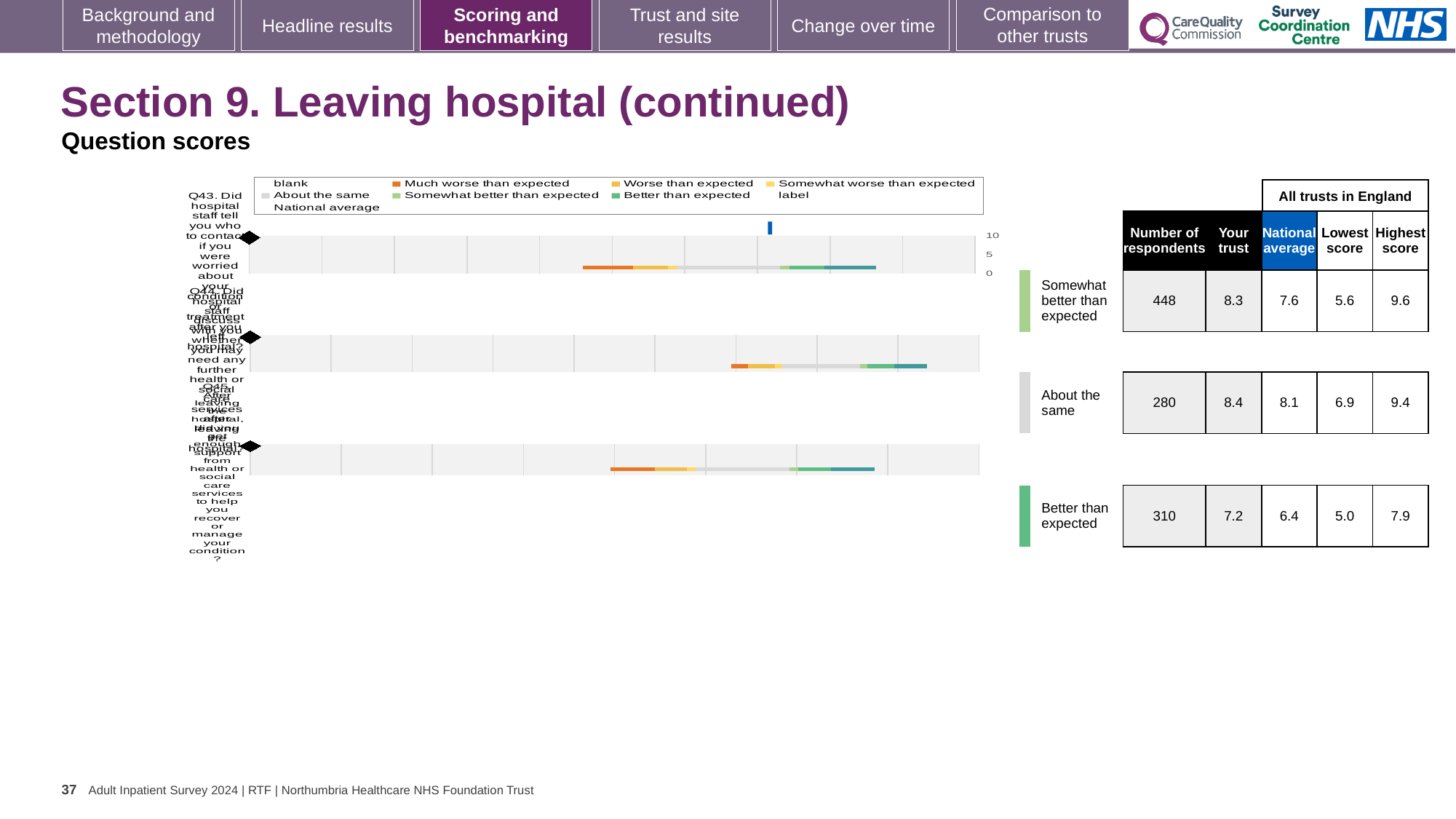
Which question row has the highest 'Your trust' score? The second question (About the same), 8.4 Which benchmark category is the first question (Q43) assigned to? Somewhat better than expected What kind of chart is used to show the question scores on this slide? Bar chart For the third question, which is larger: the 'Your trust' score or the national average? Your trust (7.2) For the first question (Q43), how much higher is the 'Your trust' score than the national average? 0.7 What is the national average score for the third question (the one rated 'Better than expected')? 6.4 How many questions (rows) are plotted in the question scores chart? 3 Which question row has the lowest 'Your trust' score? The third question (Better than expected), 7.2 What is the 'Your trust' score for the first question (Q43, about being told who to contact if worried after leaving hospital)? 8.3 What is the highest score among all trusts in England for the third question? 7.9 How many respondents answered the second question (the one rated 'About the same')? 280 For the second question, what is the difference between the highest score and the lowest score among all trusts in England? 2.5